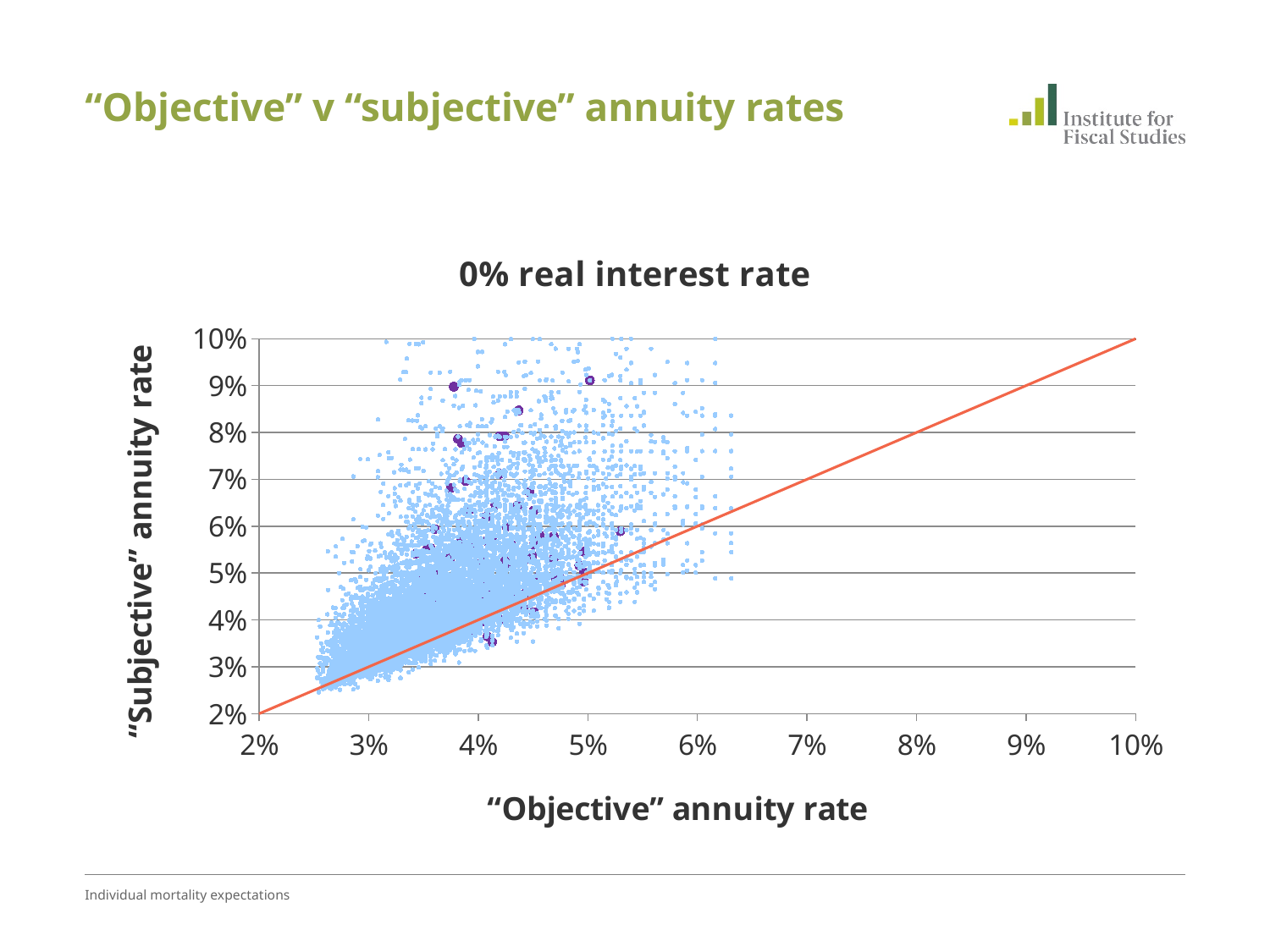
Does the red line rise or fall as the "Objective" annuity rate increases along the x axis? rise What is the label of the x axis of the chart? "Objective" annuity rate What kind of chart is shown on the slide? scatter chart Are most of the plotted points above or below the red line? above What is the title of the chart? 0% real interest rate